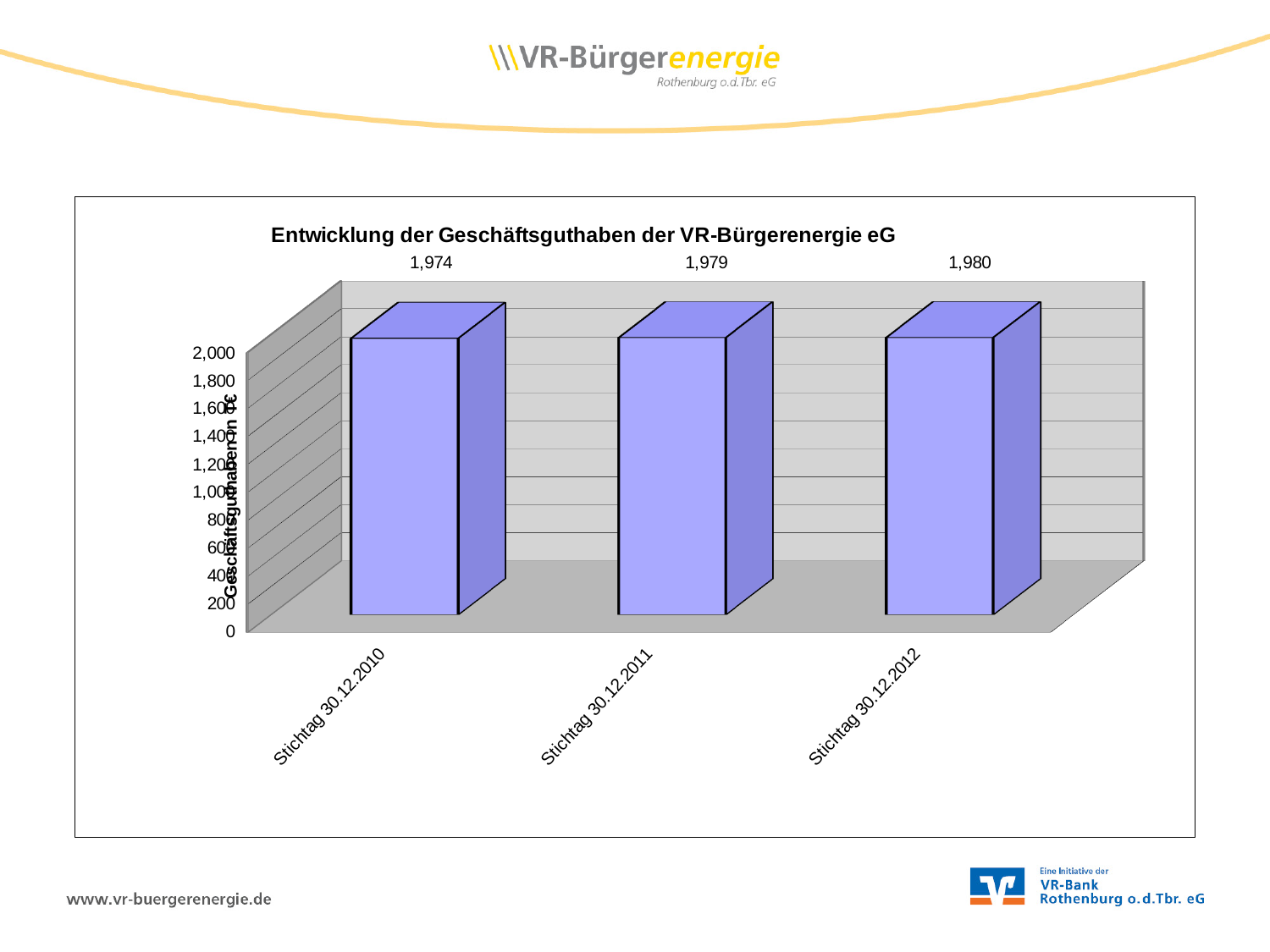
What is the difference between the values for Stichtag 30.12.2011 and Stichtag 30.12.2010? 5 What kind of chart is shown on the slide? bar chart What is the difference between the values for Stichtag 30.12.2012 and Stichtag 30.12.2010? 6 What is the value for Stichtag 30.12.2011? 1,979 Do the values rise or fall from Stichtag 30.12.2010 to Stichtag 30.12.2012? rise Is the value for Stichtag 30.12.2011 greater or less than 1,800? greater Which Stichtag has the lowest value? Stichtag 30.12.2010 How many Stichtag categories are shown on the x axis? 3 Which Stichtag has the highest value? Stichtag 30.12.2012 What is the value for Stichtag 30.12.2012? 1,980 What is the title of the chart? Entwicklung der Geschäftsguthaben der VR-Bürgerenergie eG What is the value for Stichtag 30.12.2010? 1,974